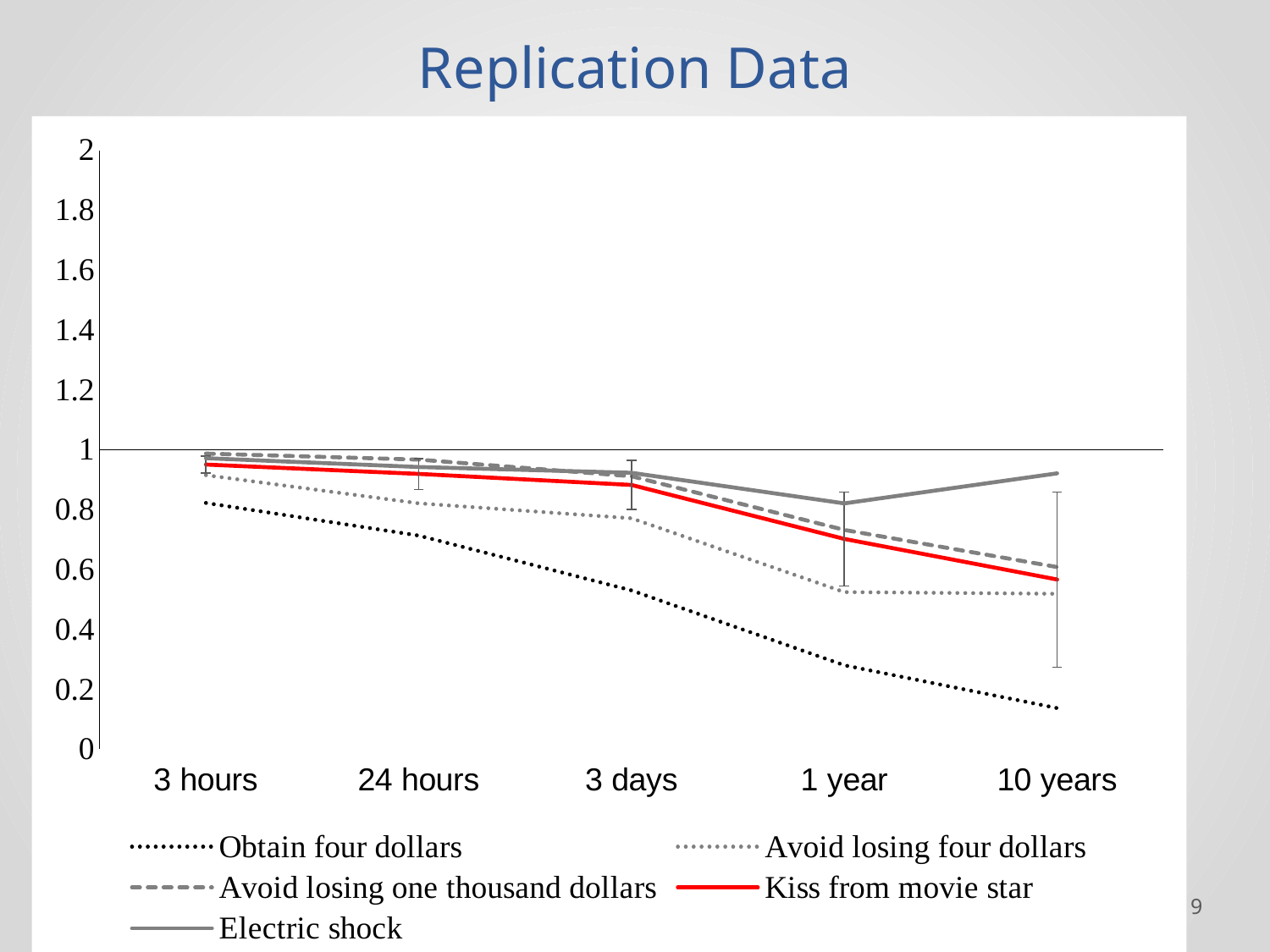
Which series is drawn as a solid red line? Kiss from movie star Do the values for Obtain four dollars rise or fall from 3 hours to 10 years? fall What is the title of the slide's chart? Replication Data What kind of chart is shown on the slide? line chart How many series does the legend list? 5 At 1 year, which is larger: Electric shock or Obtain four dollars? Electric shock Is the value for Electric shock at 10 years greater or less than 0.8? greater Is the value for Obtain four dollars at 1 year greater or less than 0.4? less How many time points are shown on the x axis? 5 Which series has the highest value at 10 years? Electric shock Is the value for Obtain four dollars at 10 years greater or less than 0.2? less Which series has the lowest value at 10 years? Obtain four dollars